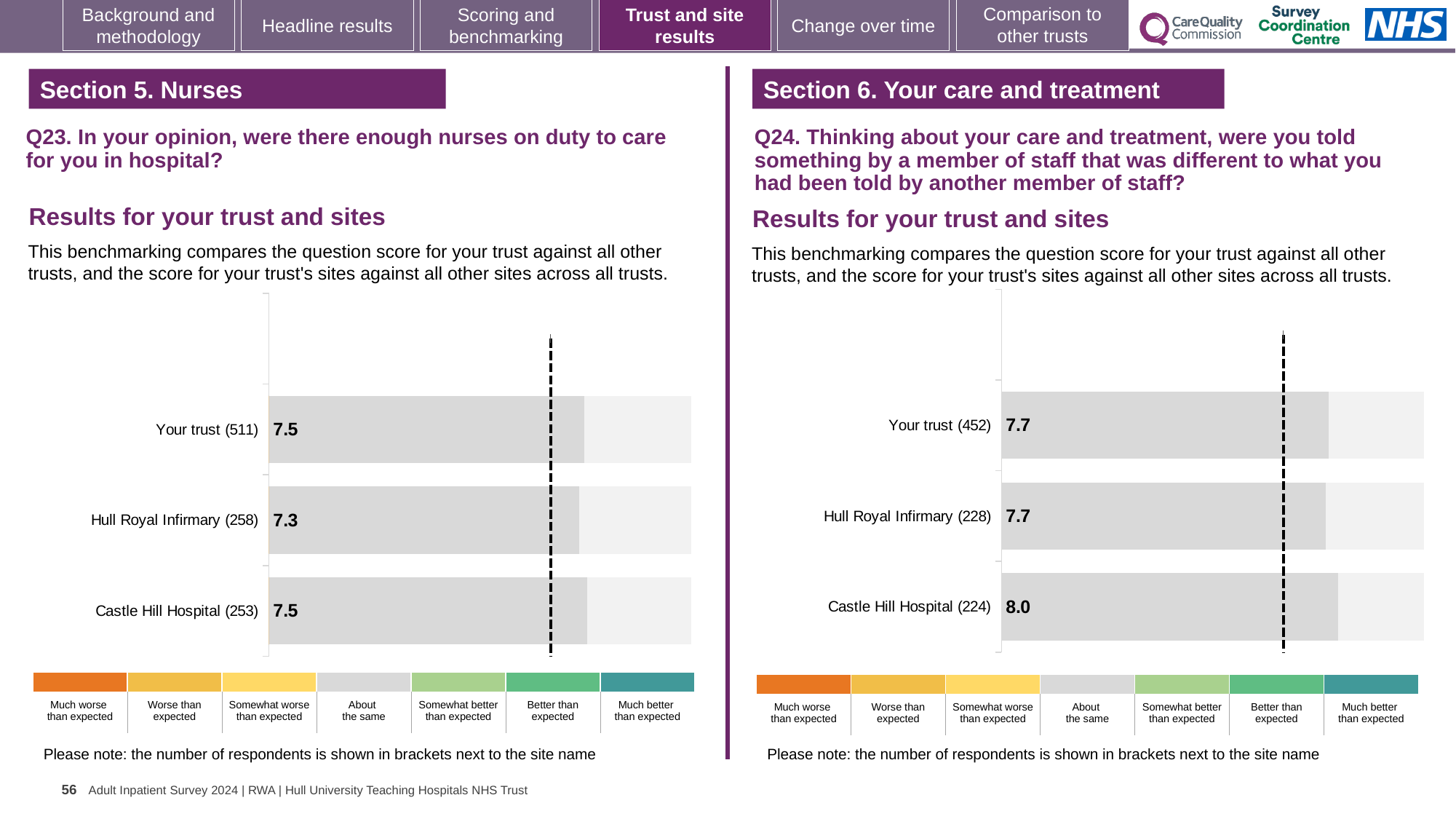
In the Q23 chart on the left, what is the score for Hull Royal Infirmary? 7.3 What kind of chart is used for the Q24 results on the right? Bar chart In the Q24 chart on the right, what is the score for Your trust? 7.7 In the Q24 chart on the right, what is the score for Castle Hill Hospital? 8.0 In the Q24 chart on the right, which site or trust has the highest score? Castle Hill Hospital In the Q24 chart on the right, what is the difference between the scores for Castle Hill Hospital and Your trust? 0.3 In the Q23 chart on the left, how many respondents are shown in brackets for Your trust? 511 In the Q23 chart on the left, what is the score for Your trust? 7.5 How many bars are plotted in the Q23 chart on the left? 3 In the Q23 chart on the left, what is the difference between the scores for Castle Hill Hospital and Hull Royal Infirmary? 0.2 In the Q23 chart on the left, which site or trust has the lowest score? Hull Royal Infirmary In the Q24 chart on the right, which has the larger score, Castle Hill Hospital or Hull Royal Infirmary? Castle Hill Hospital